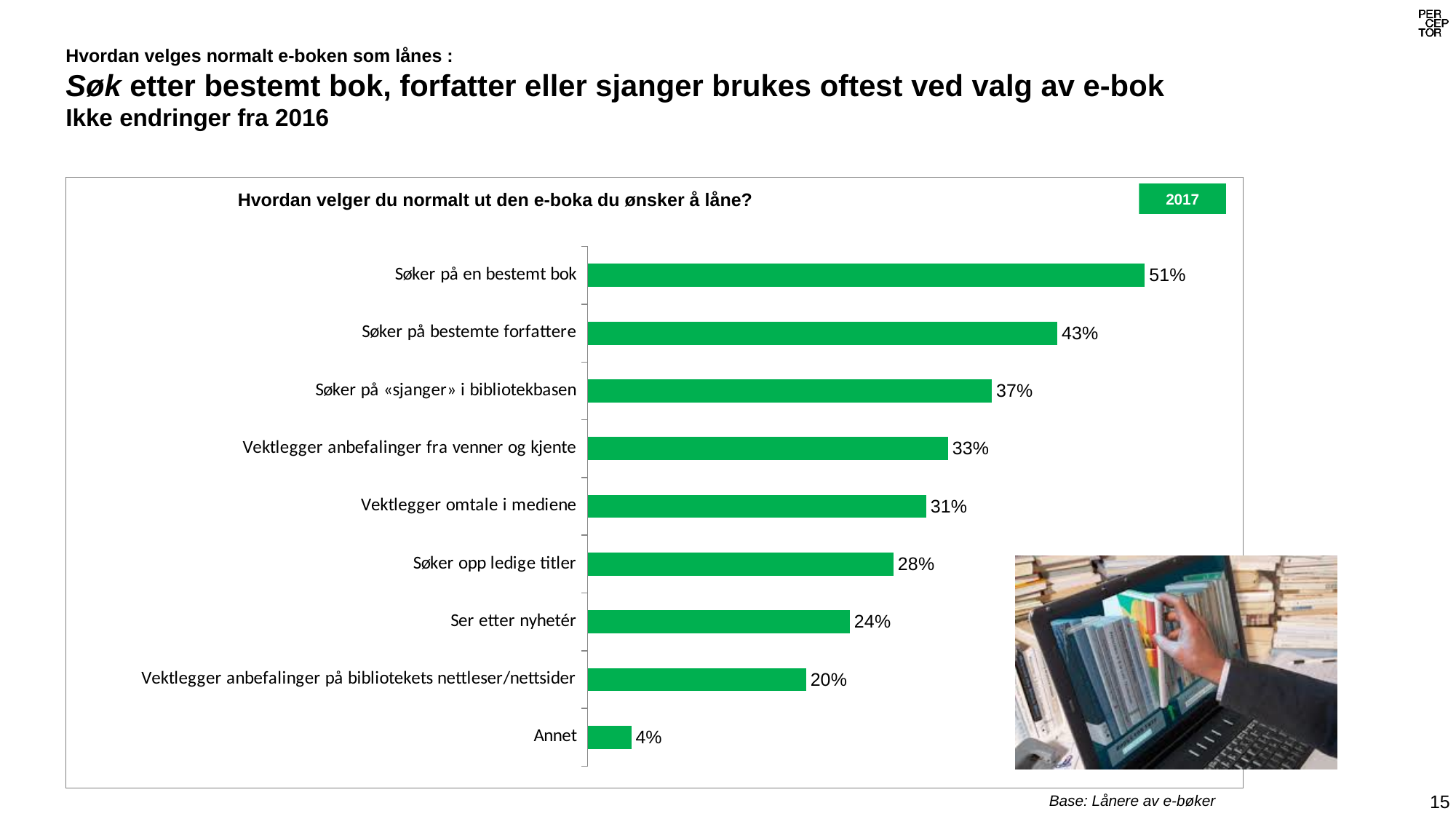
Which year does the legend label in the chart show? 2017 What is the value for "Søker på en bestemt bok"? 51% Which category has the highest value? Søker på en bestemt bok What is the difference between "Søker på bestemte forfattere" and "Søker på «sjanger» i bibliotekbasen"? 6% Which is larger: "Søker opp ledige titler" or "Ser etter nyhetér"? Søker opp ledige titler What is the value for "Vektlegger anbefalinger på bibliotekets nettleser/nettsider"? 20% Which category has the lowest value? Annet What kind of chart is shown on the slide? Bar chart What is the title of the chart? Hvordan velger du normalt ut den e-boka du ønsker å låne? What is the value for "Vektlegger omtale i mediene"? 31% How many categories are shown in the chart? 9 What is the difference between "Søker på en bestemt bok" and "Annet"? 47%